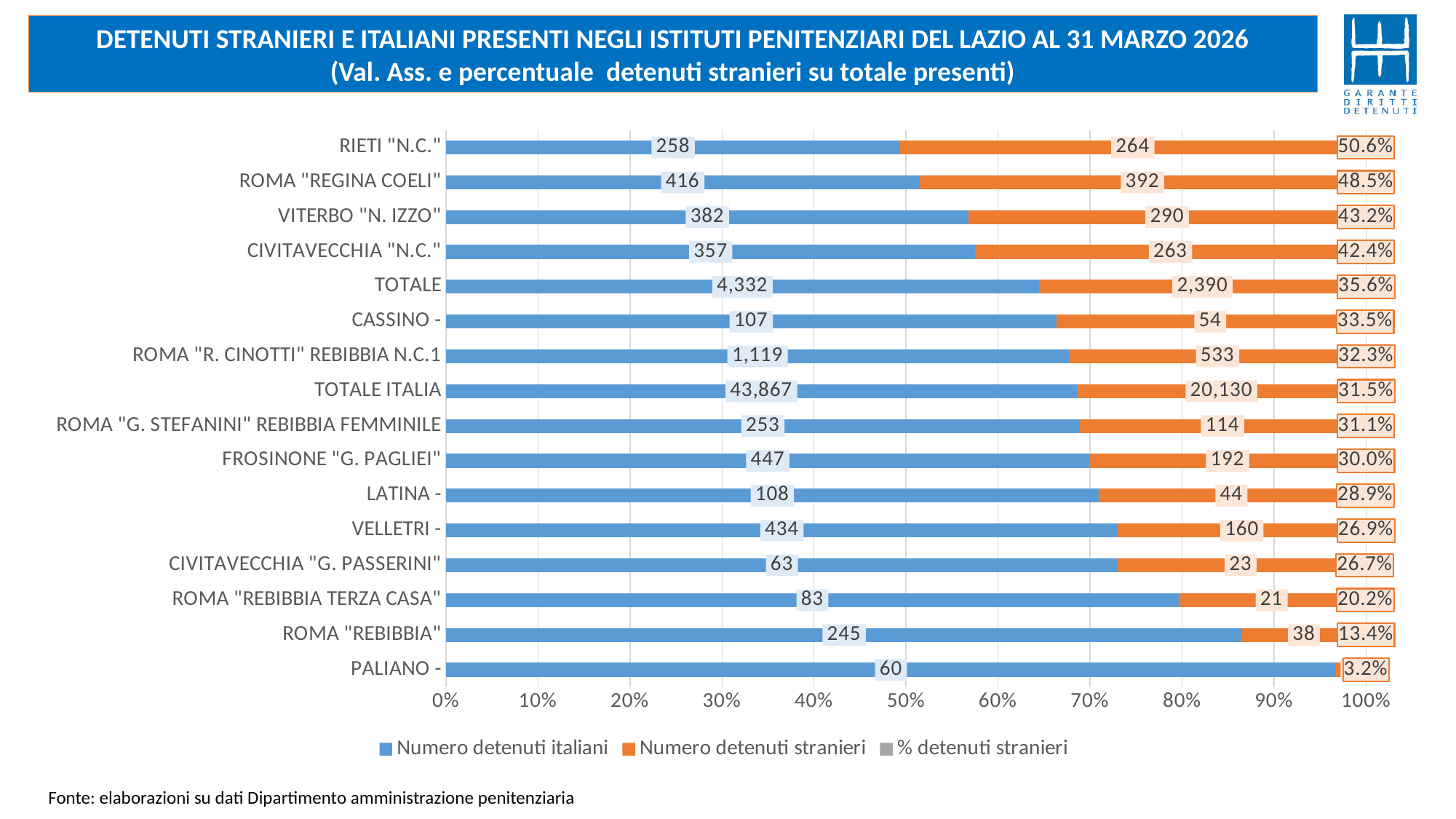
Which has more Italian detainees, VELLETRI or FROSINONE "G. PAGLIEI"? FROSINONE "G. PAGLIEI" What kind of chart is shown on the slide? Bar chart Which category has the highest percentage of foreign detainees? RIETI "N.C." How many series does the legend list? 3 What is the number of Italian detainees (Numero detenuti italiani) for RIETI "N.C."? 258 What is the total number of detainees (Italian plus foreign) for LATINA? 152 What is the number of foreign detainees (Numero detenuti stranieri) for ROMA "REGINA COELI"? 392 How many categories are listed on the vertical axis of the chart? 16 For CASSINO, what is the difference between the number of Italian detainees and the number of foreign detainees? 53 Which category has the lowest percentage of foreign detainees? PALIANO What is the number of foreign detainees shown for TOTALE ITALIA? 20,130 What is the percentage of foreign detainees (% detenuti stranieri) shown for VITERBO "N. IZZO"? 43.2%